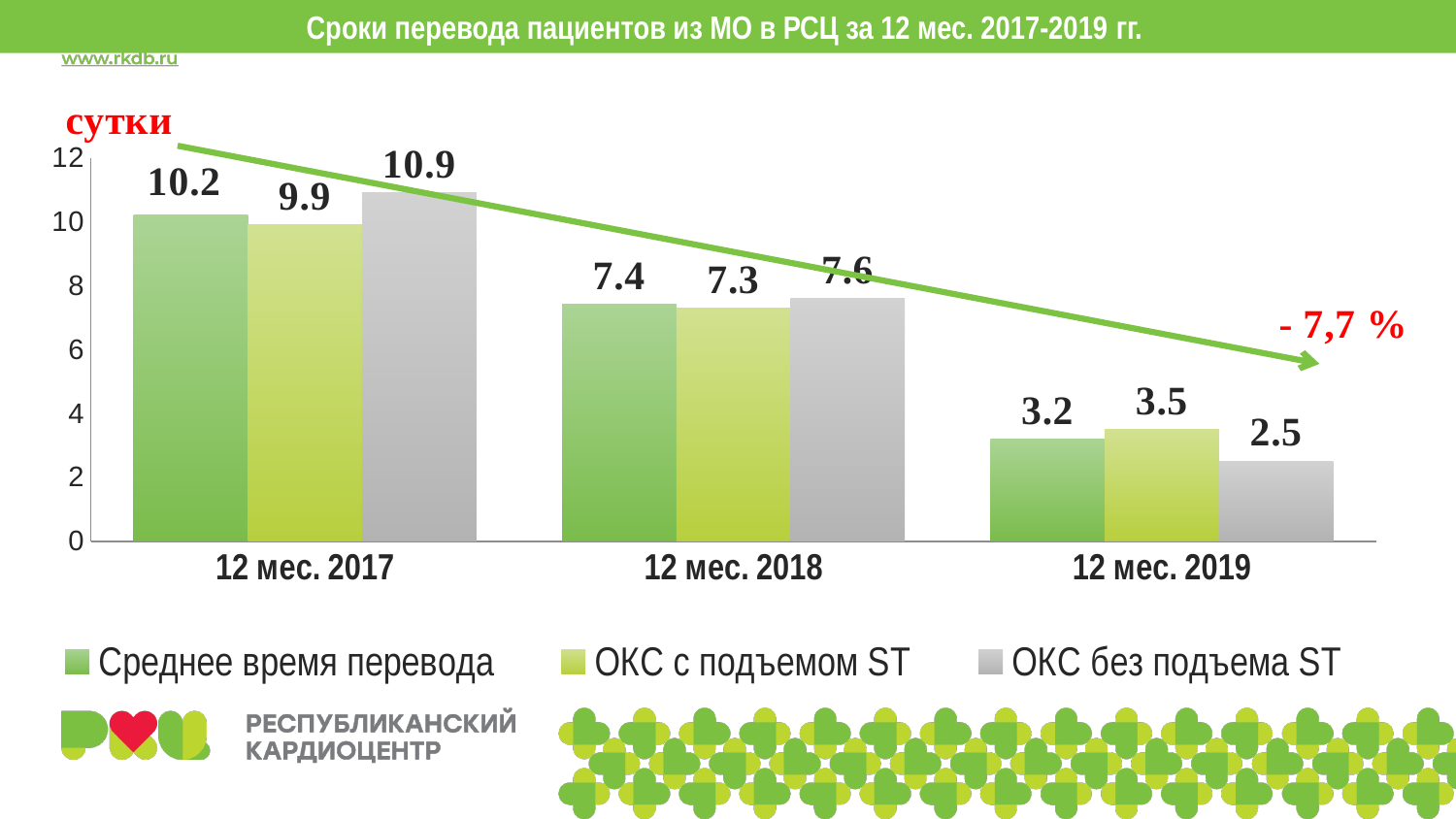
What is the value for ОКС без подъема ST in 12 мес. 2017? 10.9 Which series has the lowest value in 12 мес. 2019? ОКС без подъема ST Which is larger: ОКС с подъемом ST in 12 мес. 2019 or ОКС без подъема ST in 12 мес. 2019? ОКС с подъемом ST Which series has the highest value in 12 мес. 2017? ОКС без подъема ST How many series does the legend list? 3 What kind of chart is shown on the slide? Bar chart What is the value for Среднее время перевода in 12 мес. 2018? 7.4 What is the difference between the Среднее время перевода values for 12 мес. 2017 and 12 мес. 2019? 7.0 How many year categories are shown on the x axis? 3 What unit label is written above the y axis? сутки What is the value for ОКС с подъемом ST in 12 мес. 2019? 3.5 Do the Среднее время перевода values rise or fall from 12 мес. 2017 to 12 мес. 2019? Fall